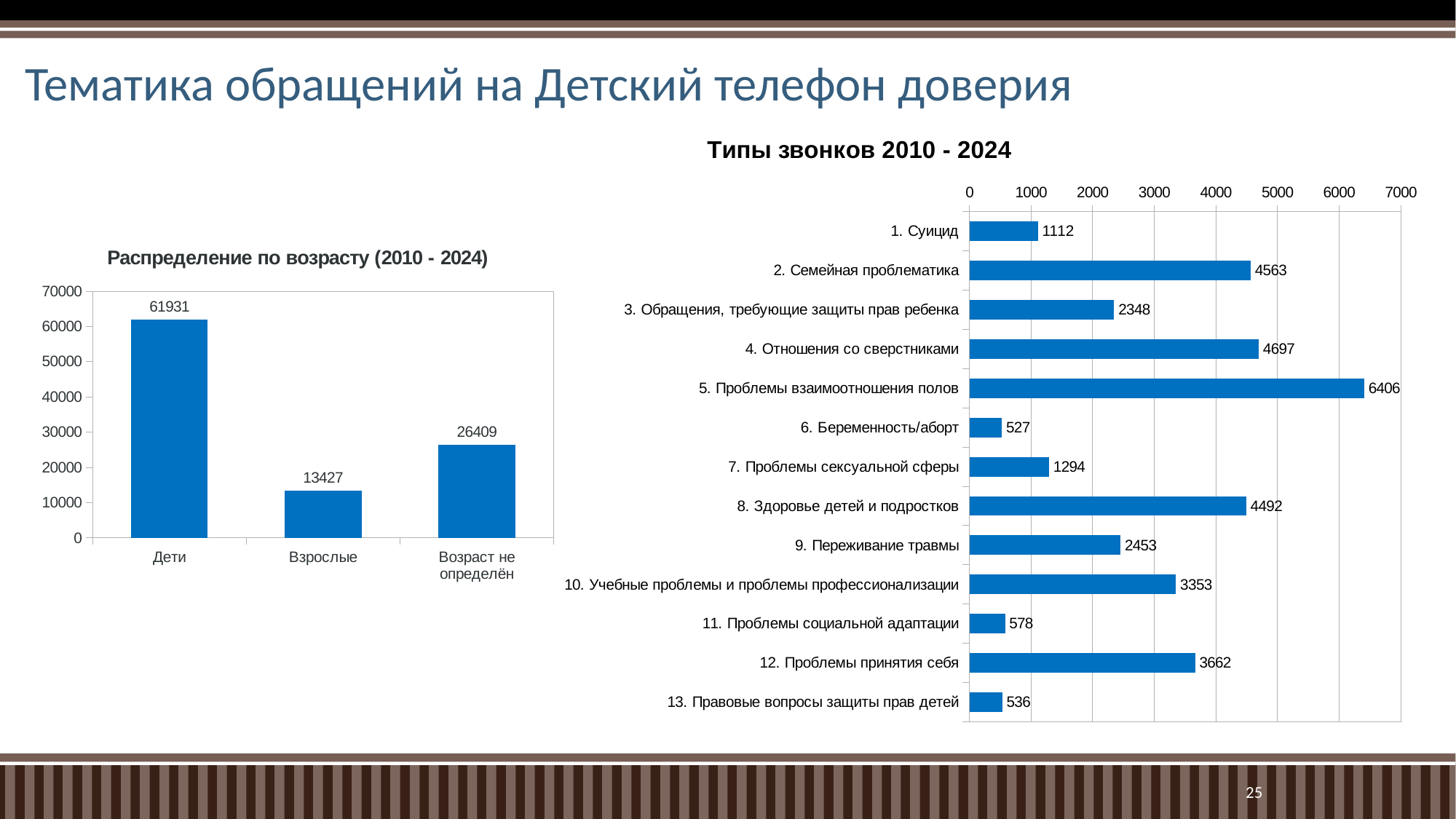
In the chart 'Типы звонков 2010 - 2024', how many categories are shown? 13 In the chart 'Типы звонков 2010 - 2024', what is the difference between '12. Проблемы принятия себя' and '10. Учебные проблемы и проблемы профессионализации'? 309 In the chart 'Типы звонков 2010 - 2024', what is the value for '5. Проблемы взаимоотношения полов'? 6406 In the chart 'Распределение по возрасту (2010 - 2024)', what is the difference between the values for Дети and Возраст не определён? 35522 In the chart 'Распределение по возрасту (2010 - 2024)', what is the value for Дети? 61931 What kind of chart is 'Типы звонков 2010 - 2024'? Bar chart In the chart 'Типы звонков 2010 - 2024', what is the value for '9. Переживание травмы'? 2453 In the chart 'Типы звонков 2010 - 2024', which is larger: '2. Семейная проблематика' or '8. Здоровье детей и подростков'? 2. Семейная проблематика In the chart 'Типы звонков 2010 - 2024', which category has the lowest value? 6. Беременность/аборт In the chart 'Типы звонков 2010 - 2024', which category has the highest value? 5. Проблемы взаимоотношения полов In the chart 'Распределение по возрасту (2010 - 2024)', which category has the lowest value? Взрослые In the chart 'Распределение по возрасту (2010 - 2024)', how many categories are shown? 3